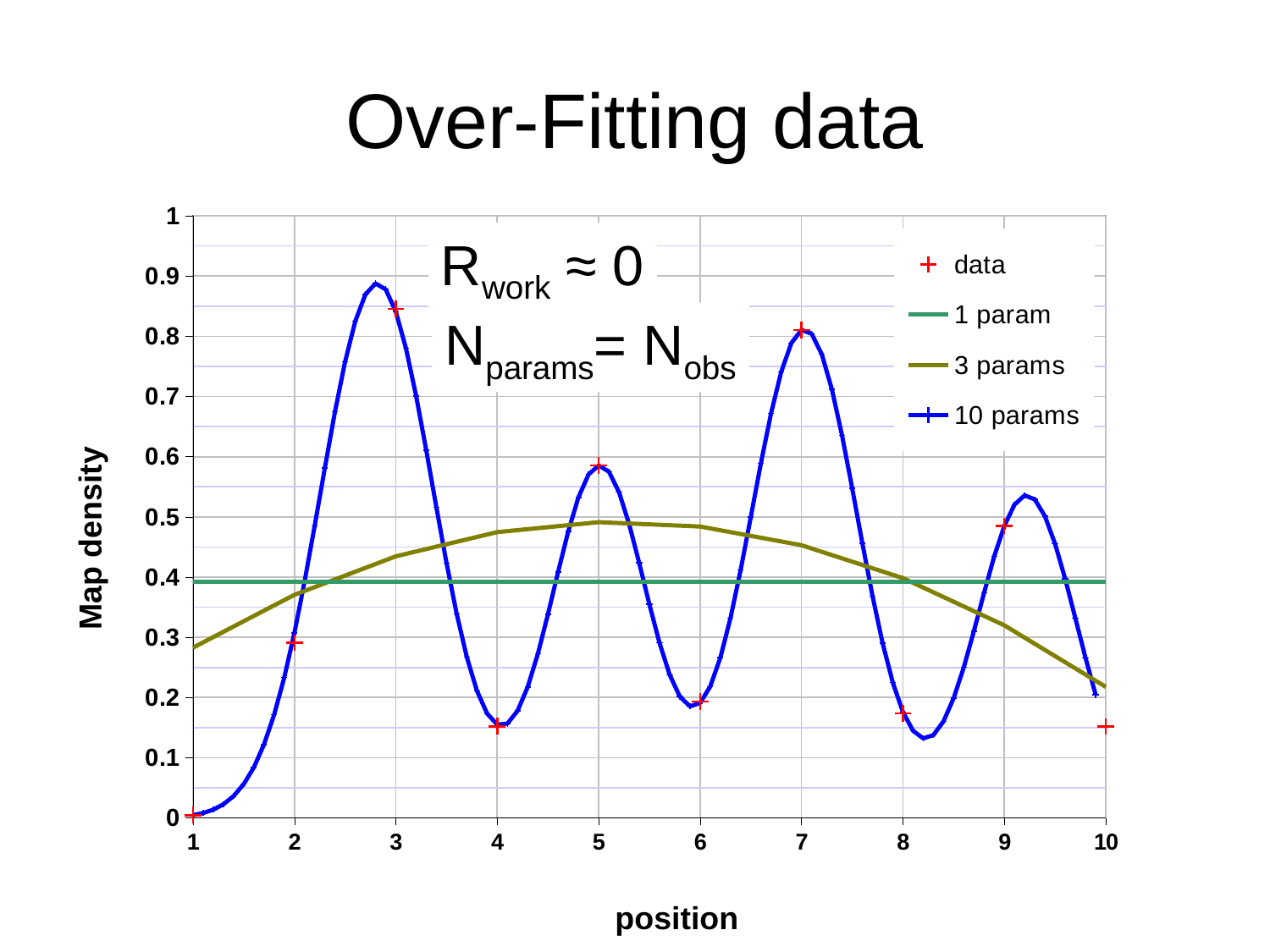
Is the 'data' value at position 4 greater or less than 0.2? less What kind of chart is shown on the slide? line chart Which is larger, the 'data' value at position 2 or at position 9? position 9 Is the 'data' value at position 5 greater or less than 0.5? greater Which is larger, the 'data' value at position 5 or at position 6? position 5 At which position is the 'data' value lowest? 1 How many series does the legend list? 4 What is the title of the chart on the slide? Over-Fitting data How many data points (red crosses) are plotted for the 'data' series? 10 Is the 'data' value at position 3 greater or less than 0.8? greater What is the label of the y axis? Map density Does the '1 param' line rise, fall, or stay flat across the x axis? stay flat